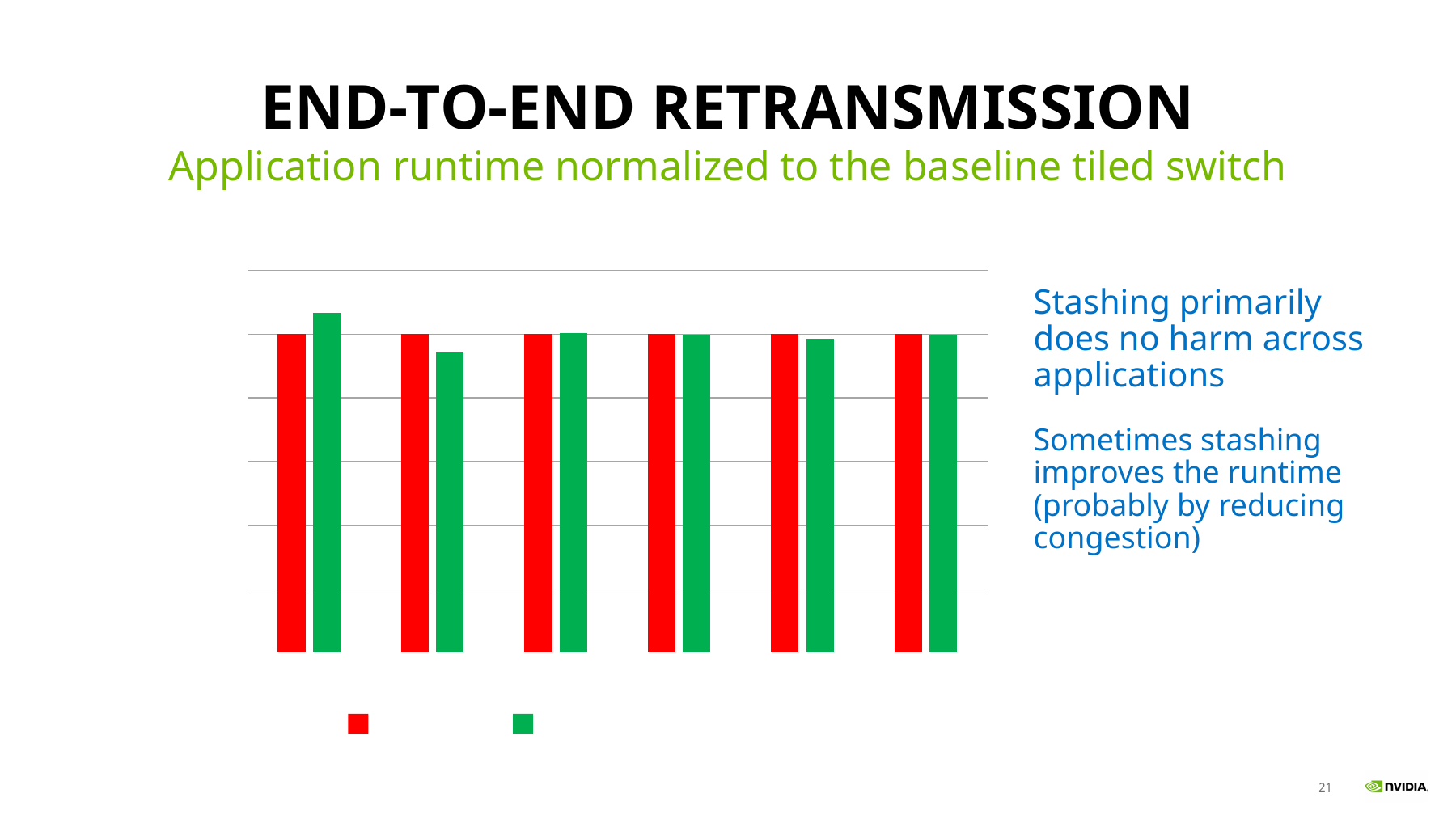
Which group of bars, counted from the left, has the shortest green bar? the second What two colours are used for the bars in the chart? red and green What is the subtitle describing what the chart plots? Application runtime normalized to the baseline tiled switch What kind of chart is shown on the slide? bar chart Are the red bars all the same height across the six groups? yes Which group of bars, counted from the left, has the tallest green bar? the first In the leftmost group of bars, which bar is taller, the red one or the green one? green How many series does the chart's legend list? 2 In the second group of bars from the left, which bar is taller, the red one or the green one? red How many groups of bars does the chart contain? 6